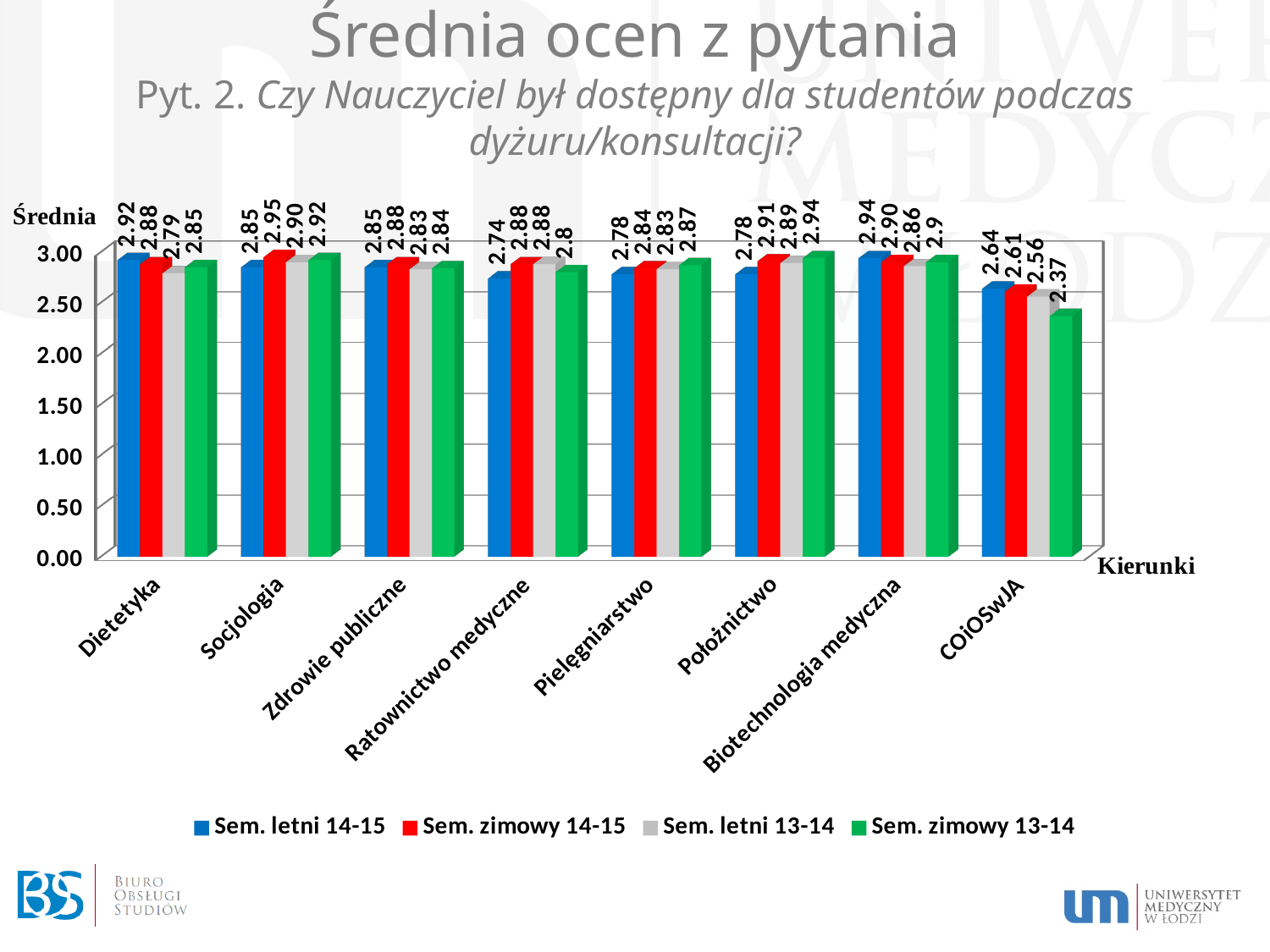
Is the value for COiOSwJA in the Sem. zimowy 13-14 series greater or less than 2.50? less What is the value for Socjologia in the Sem. zimowy 14-15 series? 2.95 What is the difference between the Sem. letni 14-15 value and the Sem. zimowy 13-14 value for COiOSwJA? 0.27 Which category has the highest value in the Sem. letni 14-15 series? Biotechnologia medyczna What is the value for COiOSwJA in the Sem. zimowy 13-14 series? 2.37 How many categories (Kierunki) are shown on the x axis? 8 What is the value for Ratownictwo medyczne in the Sem. letni 14-15 series? 2.74 Which is larger for Położnictwo: the Sem. letni 14-15 value or the Sem. zimowy 13-14 value? Sem. zimowy 13-14 Which category has the lowest value in the Sem. letni 13-14 series? COiOSwJA How many series does the legend list? 4 What kind of chart is shown on the slide? bar chart What is the value for Dietetyka in the Sem. letni 14-15 series? 2.92